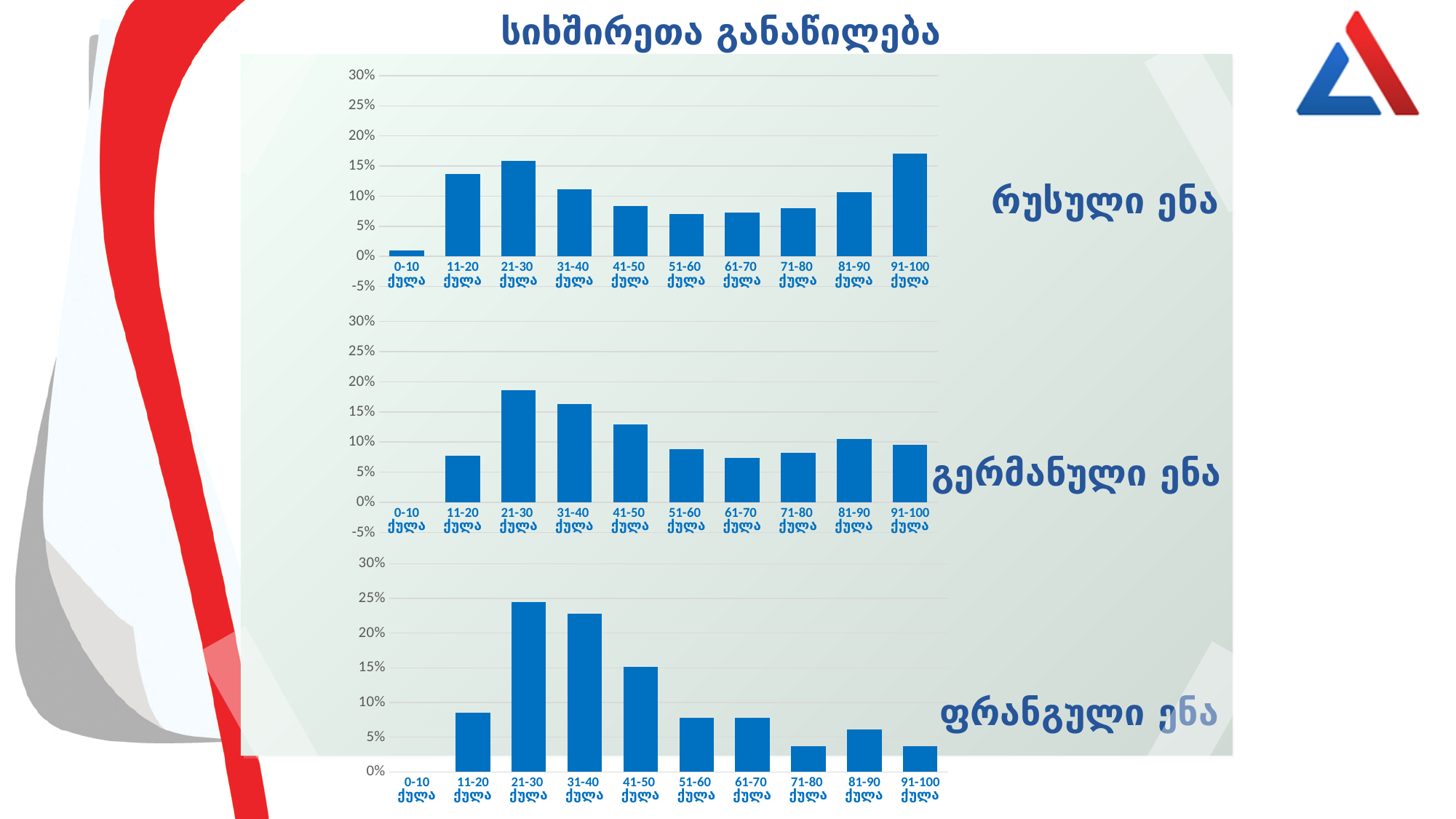
In the ფრანგული ენა chart, which is larger, the value for 21-30 ქულა or the value for 51-60 ქულა? 21-30 ქულა In the ფრანგული ენა chart, is the value for 71-80 ქულა greater or less than 5%? less In the გერმანული ენა chart, which is larger, the value for 31-40 ქულა or the value for 11-20 ქულა? 31-40 ქულა What is the title at the top of the slide? სიხშირეთა განაწილება In the რუსული ენა chart, which score category has the lowest bar? 0-10 ქულა In the რუსული ენა chart, is the value for 91-100 ქულა greater or less than 15%? greater In the გერმანული ენა chart, which score category has the highest bar? 21-30 ქულა In the ფრანგული ენა chart, do the values rise or fall from 21-30 ქულა to 51-60 ქულა? fall In the გერმანული ენა chart, how many score categories are shown on the x axis? 10 What kind of chart is used for the რუსული ენა data? bar chart How many charts are shown on the slide? 3 In the ფრანგული ენა chart, is the value for 21-30 ქულა greater or less than 20%? greater